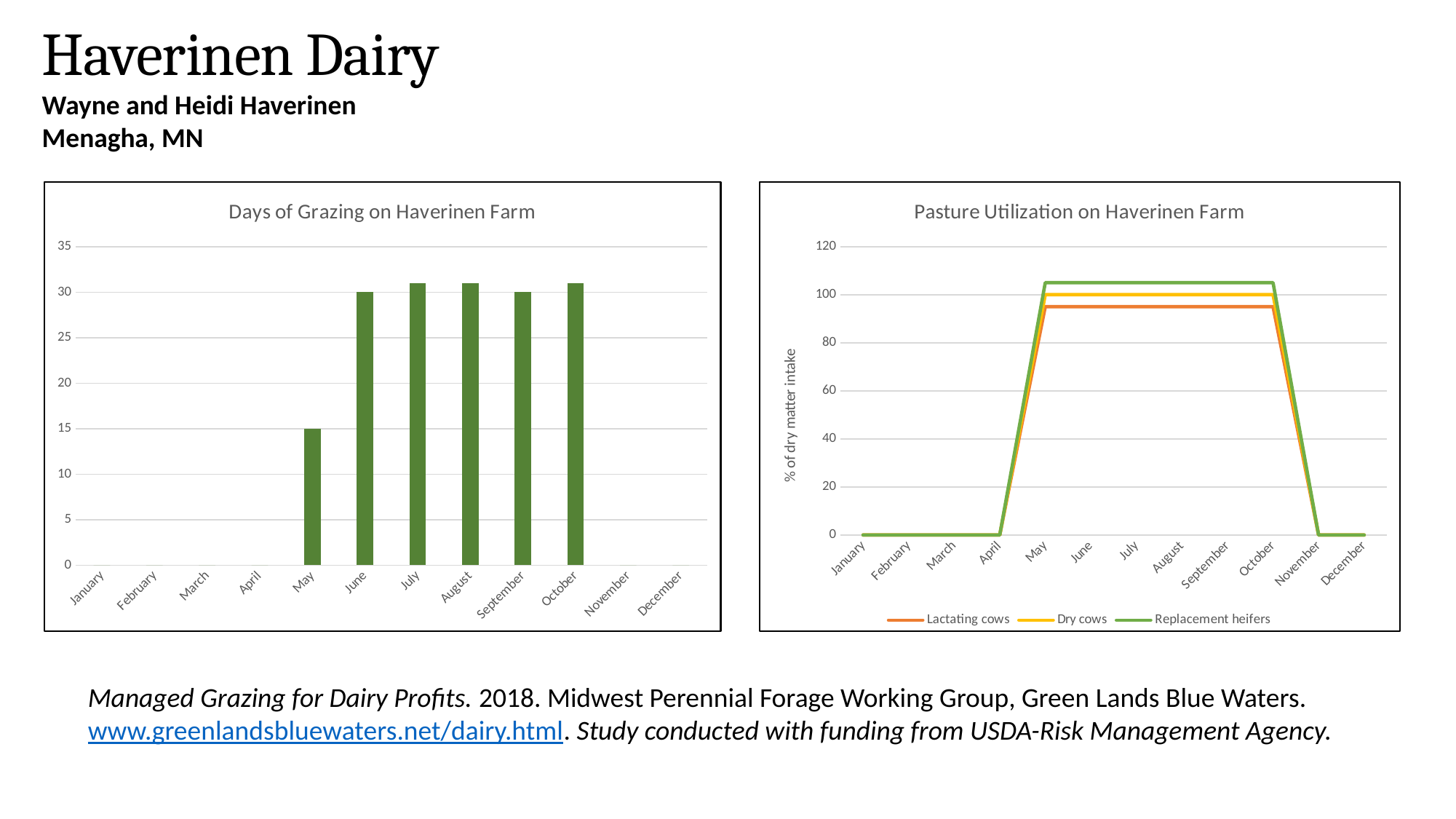
In the 'Pasture Utilization on Haverinen Farm' chart, which series has the highest value in July? Replacement heifers In the 'Days of Grazing on Haverinen Farm' chart, what is the value for May? 15 In the 'Days of Grazing on Haverinen Farm' chart, how many months are shown on the x axis? 12 In the 'Days of Grazing on Haverinen Farm' chart, do the values rise or fall from April to May? rise In the 'Pasture Utilization on Haverinen Farm' chart, how many series does the legend list? 3 In the 'Pasture Utilization on Haverinen Farm' chart, is the value for Lactating cows in August greater or less than 80? greater In the 'Days of Grazing on Haverinen Farm' chart, which is larger, the value for May or the value for June? June What kind of chart is 'Days of Grazing on Haverinen Farm'? bar chart In the 'Pasture Utilization on Haverinen Farm' chart, what is the value for Dry cows in June? 100 In the 'Days of Grazing on Haverinen Farm' chart, what is the value for June? 30 What kind of chart is 'Pasture Utilization on Haverinen Farm'? line chart In the 'Days of Grazing on Haverinen Farm' chart, is the value for July greater or less than 25? greater